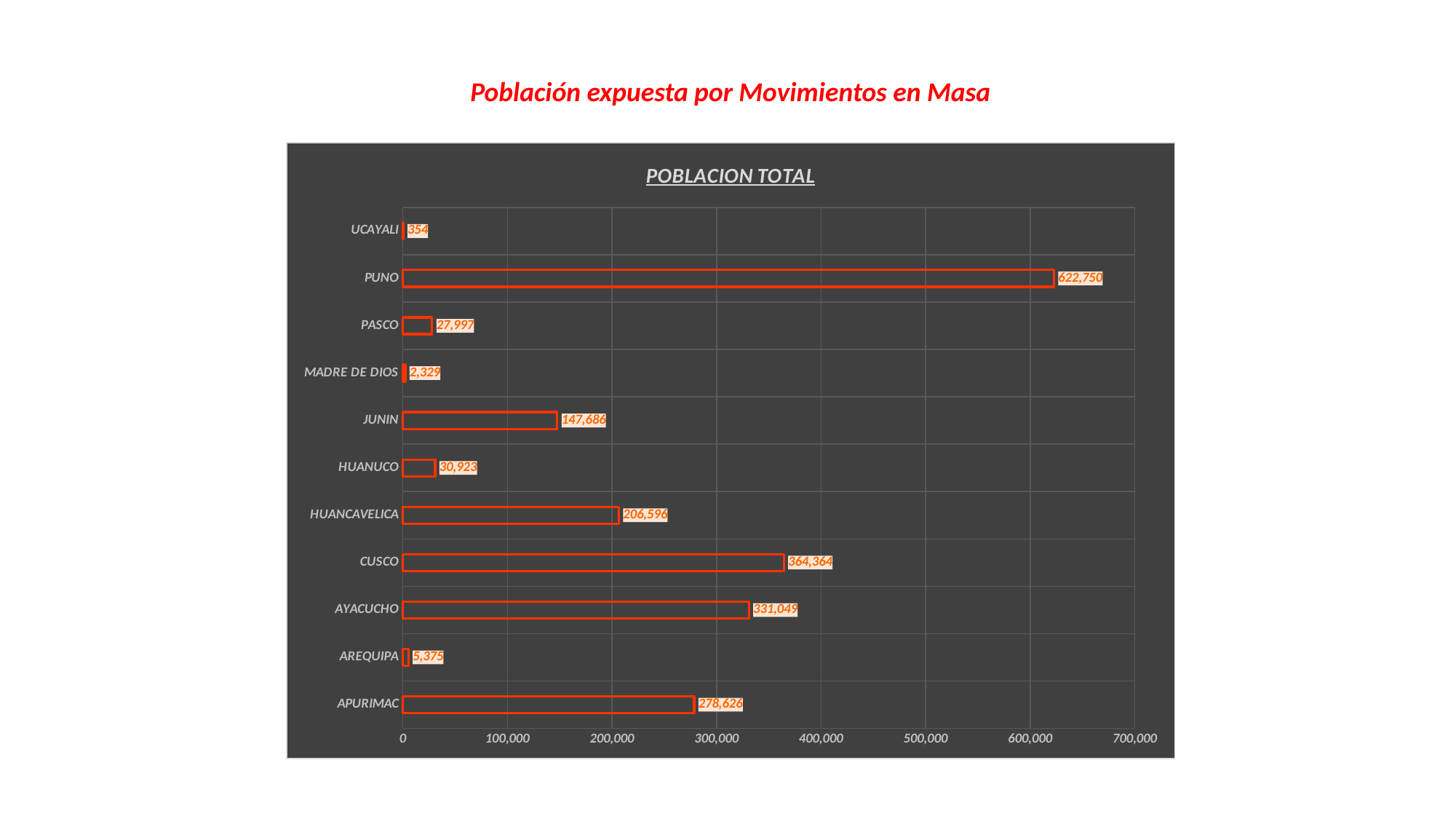
Is the value for CUSCO greater or less than 300,000? greater What is the value for HUANCAVELICA? 206,596 What kind of chart is shown? bar chart How many categories are shown on the chart? 11 What is the value for MADRE DE DIOS? 2,329 Which category has the lowest value? UCAYALI What is the difference between the values for CUSCO and AYACUCHO? 33,315 What is the title of the chart? POBLACION TOTAL Which is larger, the value for JUNIN or the value for HUANCAVELICA? HUANCAVELICA What is the value for APURIMAC? 278,626 Which category has the highest value? PUNO What is the value for PUNO? 622,750